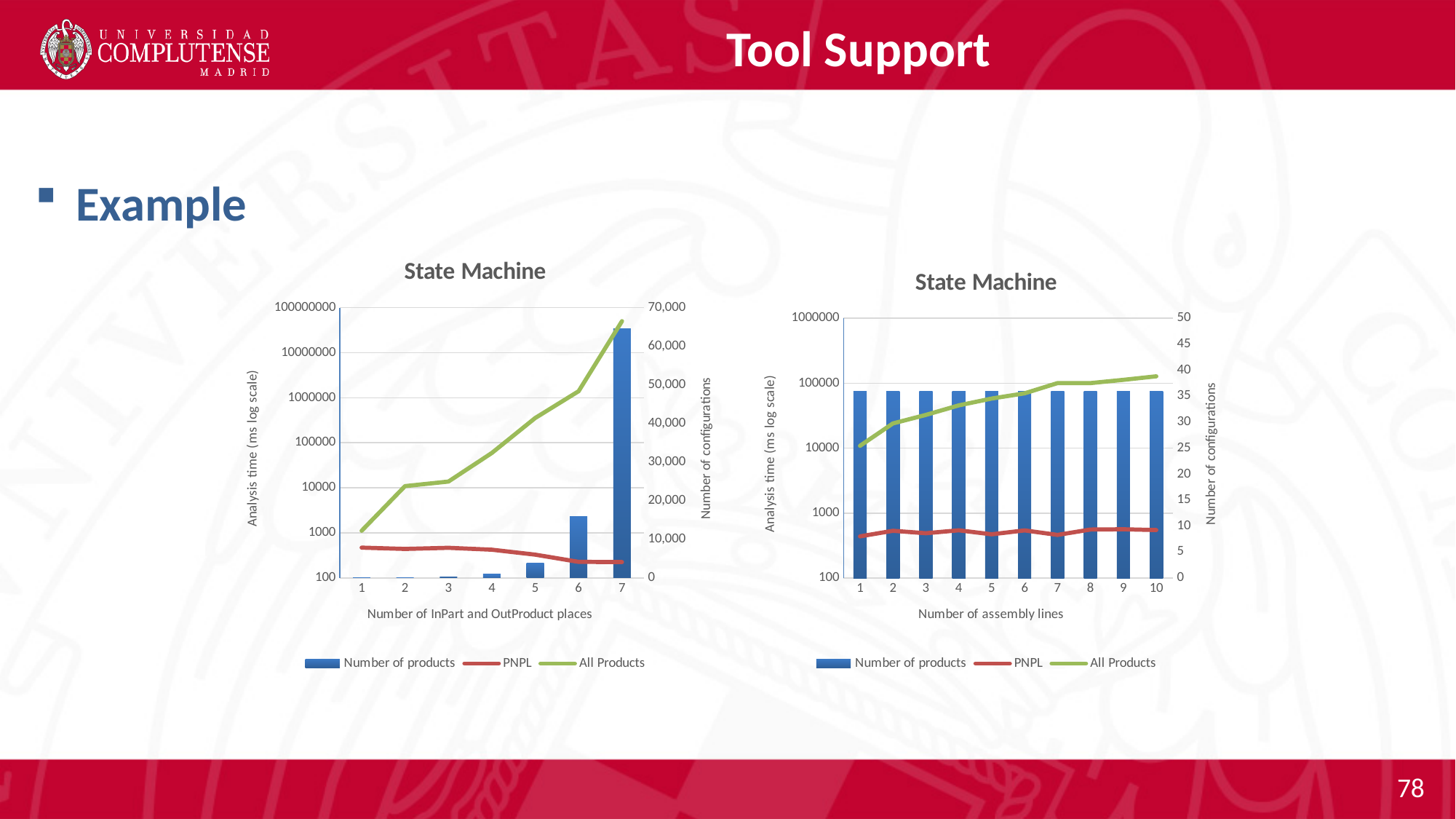
In the right chart (x axis 'Number of assembly lines'), is the Number of products value at category 5 greater or less than 100000? less How many series does the legend of the right chart (x axis 'Number of assembly lines') list? 3 What is the title of the left vertical axis of the right chart (x axis 'Number of assembly lines')? Analysis time (ms log scale) How many categories are shown on the x axis of the right chart (x axis 'Number of assembly lines')? 10 In the right chart (x axis 'Number of assembly lines'), is the All Products value at category 10 greater or less than 35? greater In the right chart (x axis 'Number of assembly lines'), does the All Products line rise or fall as the number of assembly lines increases? Rise In the left chart (x axis 'Number of InPart and OutProduct places'), does the All Products line rise or fall as the number of places increases? Rise In the left chart (x axis 'Number of InPart and OutProduct places'), is the Number of products value at category 7 greater or less than 10000000? less In the left chart (x axis 'Number of InPart and OutProduct places'), at which category is the Number of products bar highest? 7 How many categories are shown on the x axis of the left chart (x axis 'Number of InPart and OutProduct places')? 7 What kind of chart is the left chart (x axis 'Number of InPart and OutProduct places')? Combined bar and line chart